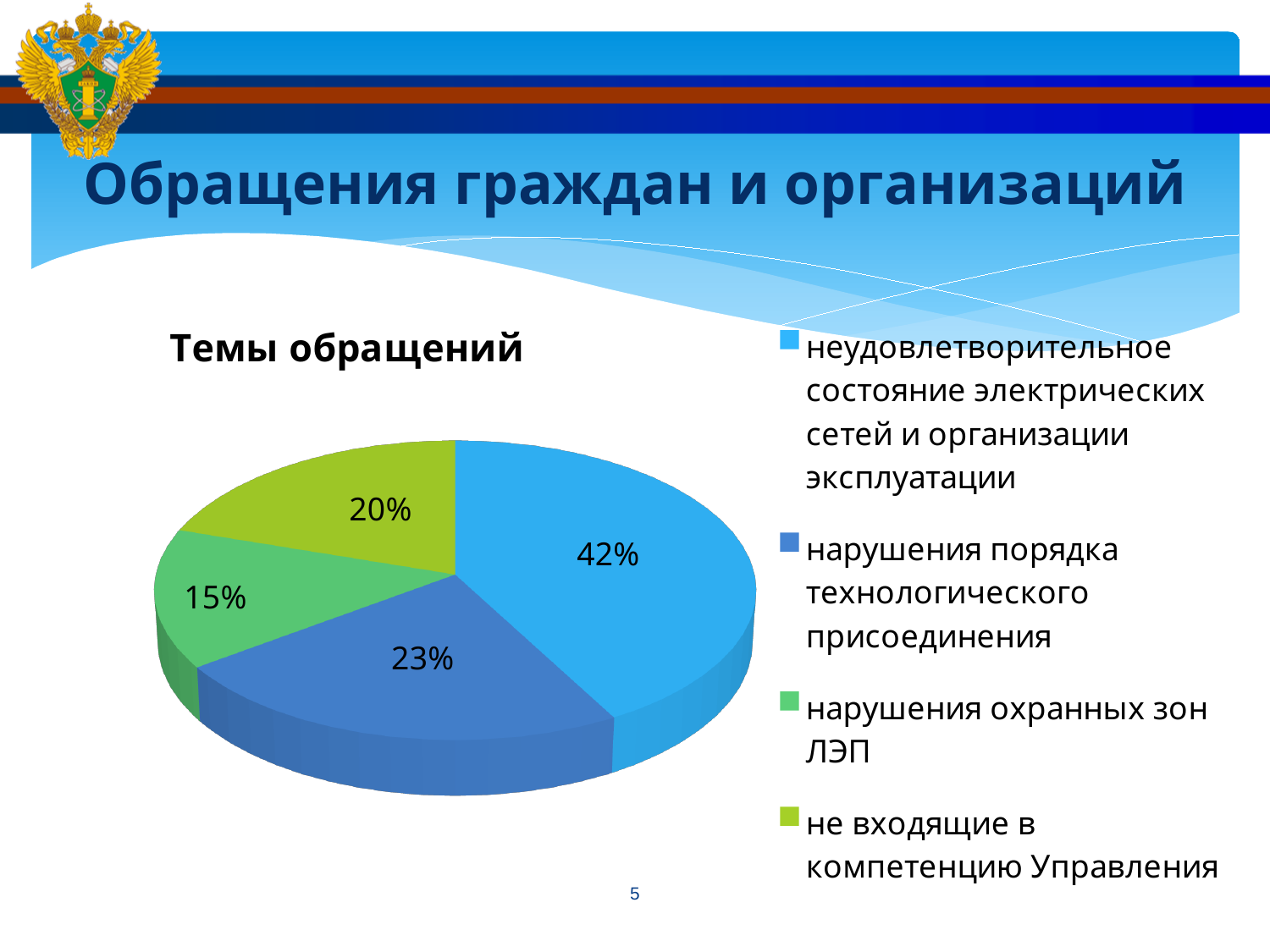
What kind of chart is shown on the slide? Pie chart Which category has the smallest share of the pie? нарушения охранных зон ЛЭП What share of the pie is "неудовлетворительное состояние электрических сетей и организации эксплуатации"? 42% What share of the pie is "не входящие в компетенцию Управления"? 20% Which is larger: the share for "не входящие в компетенцию Управления" or the share for "нарушения охранных зон ЛЭП"? не входящие в компетенцию Управления What colour is the slice for "нарушения охранных зон ЛЭП"? Green What share of the pie is "нарушения охранных зон ЛЭП"? 15% Which category has the largest share of the pie? неудовлетворительное состояние электрических сетей и организации эксплуатации What share of the pie is "нарушения порядка технологического присоединения"? 23% What is the difference between the shares for "неудовлетворительное состояние электрических сетей и организации эксплуатации" and "нарушения порядка технологического присоединения"? 19% What is the title of the chart? Темы обращений How many categories does the pie chart have? 4